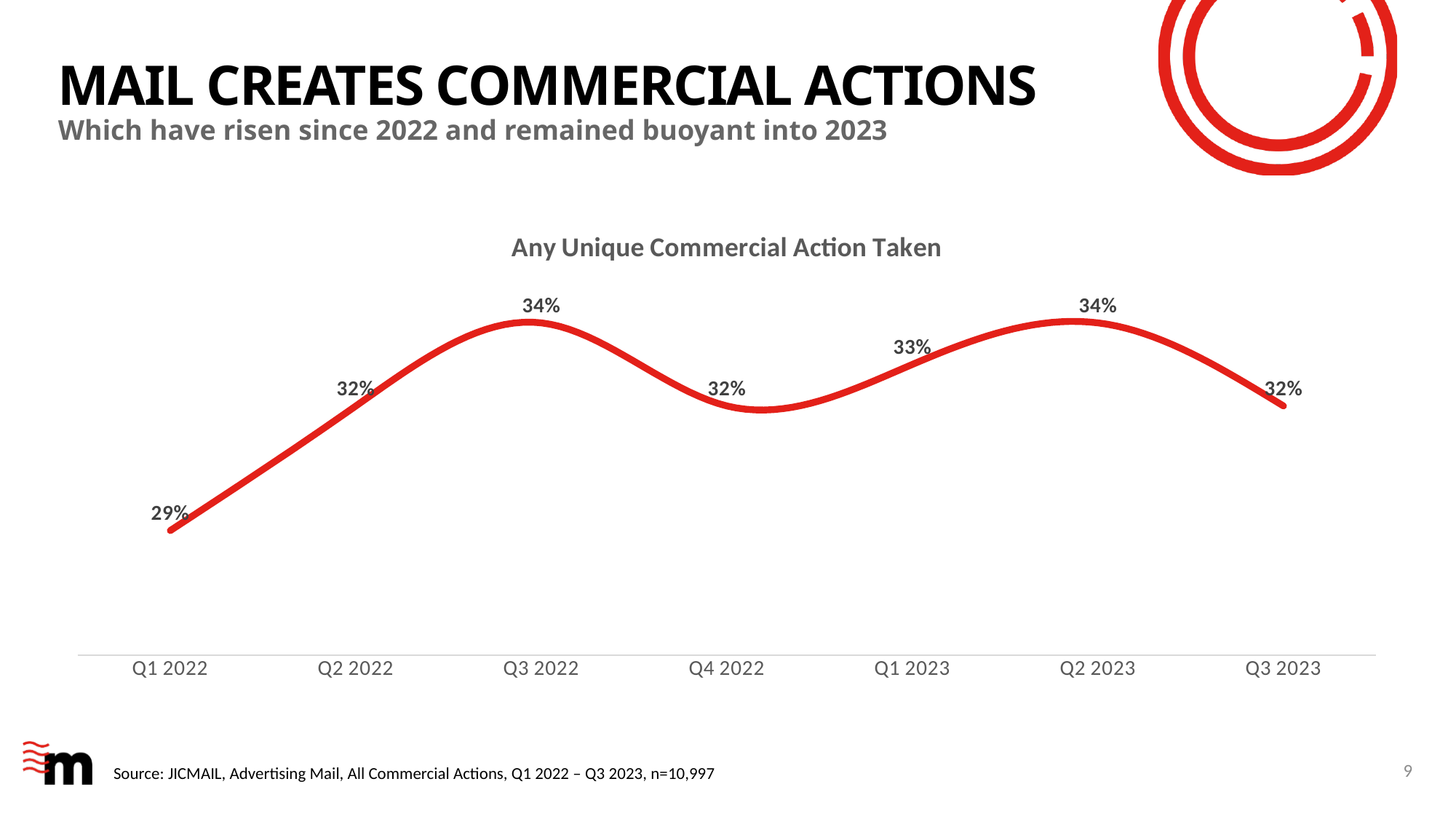
What is the difference between the values for Q2 2023 and Q3 2023? 2% What is the difference between the values for Q3 2022 and Q1 2022? 5% Which quarter has the lowest value? Q1 2022 What is the title of the chart? Any Unique Commercial Action Taken Does the value rise or fall from Q1 2022 to Q3 2022? Rise What kind of chart is shown on the slide? Line chart What is the value for Q1 2023? 33% What is the value for Q3 2023? 32% What is the value for Q1 2022? 29% How many quarters are plotted on the chart? 7 What is the value for Q3 2022? 34% Which is larger, the value for Q1 2023 or the value for Q4 2022? Q1 2023